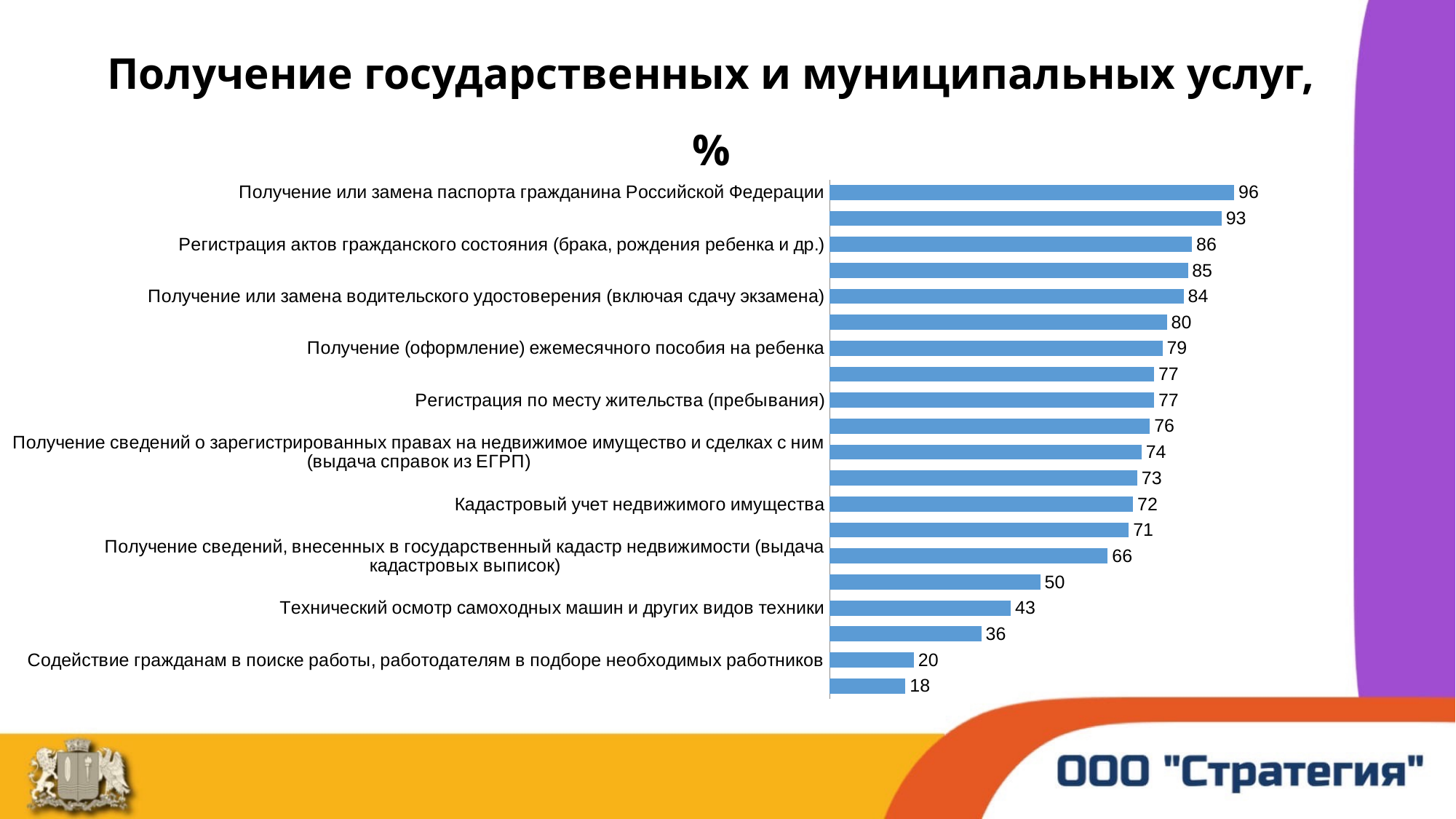
What type of chart is shown on the slide? bar chart Which is larger: the value for "Регистрация по месту жительства (пребывания)" or the value for "Получение сведений, внесенных в государственный кадастр недвижимости (выдача кадастровых выписок)"? Регистрация по месту жительства (пребывания) What is the value for "Получение (оформление) ежемесячного пособия на ребенка"? 79 Which category has the highest value in the chart? Получение или замена паспорта гражданина Российской Федерации What is the difference between the values for "Получение или замена паспорта гражданина Российской Федерации" and "Технический осмотр самоходных машин и других видов техники"? 53 How many bars are plotted in the chart? 20 What is the value for "Содействие гражданам в поиске работы, работодателям в подборе необходимых работников"? 20 What is the value for "Получение или замена водительского удостоверения (включая сдачу экзамена)"? 84 What is the value for "Регистрация актов гражданского состояния (брака, рождения ребенка и др.)"? 86 What is the lowest value shown in the chart? 18 What is the value for "Получение или замена паспорта гражданина Российской Федерации"? 96 What is the value for "Кадастровый учет недвижимого имущества"? 72